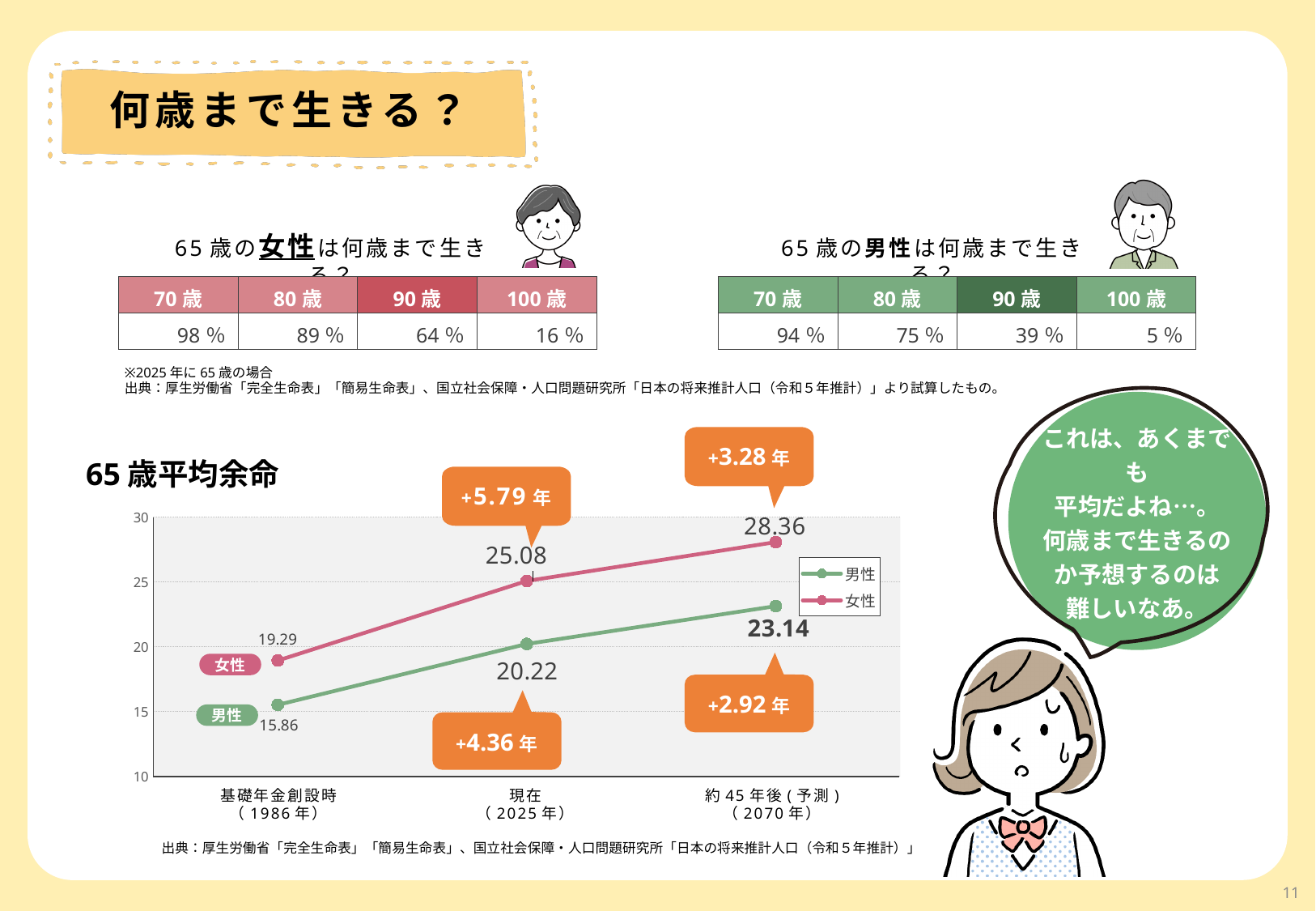
How many series does the legend of the 65歳平均余命 chart list? 2 In the 65歳平均余命 chart, what is the difference between the 女性 and 男性 values at 現在 (2025年)? 4.86 In the 65歳平均余命 chart, at which x-axis point is the 女性 value highest? 約45年後 (予測) (2070年) In the 65歳平均余命 chart, what is the value for 女性 at 約45年後 (2070年)? 28.36 In the 65歳平均余命 chart, which series has the larger value at 基礎年金創設時 (1986年), 男性 or 女性? 女性 What type of chart is the 65歳平均余命 chart? line chart In the 65歳平均余命 chart, at which x-axis point is the 男性 value lowest? 基礎年金創設時 (1986年) In the 65歳平均余命 chart, what is the value for 男性 at 約45年後 (2070年)? 23.14 In the 65歳平均余命 chart, what is the value for 男性 at 基礎年金創設時 (1986年)? 15.86 How many points along the x axis does the 65歳平均余命 chart have? 3 In the 65歳平均余命 chart, do the 男性 values rise or fall from 1986年 to 2070年? rise In the 65歳平均余命 chart, what is the value for 女性 at 現在 (2025年)? 25.08